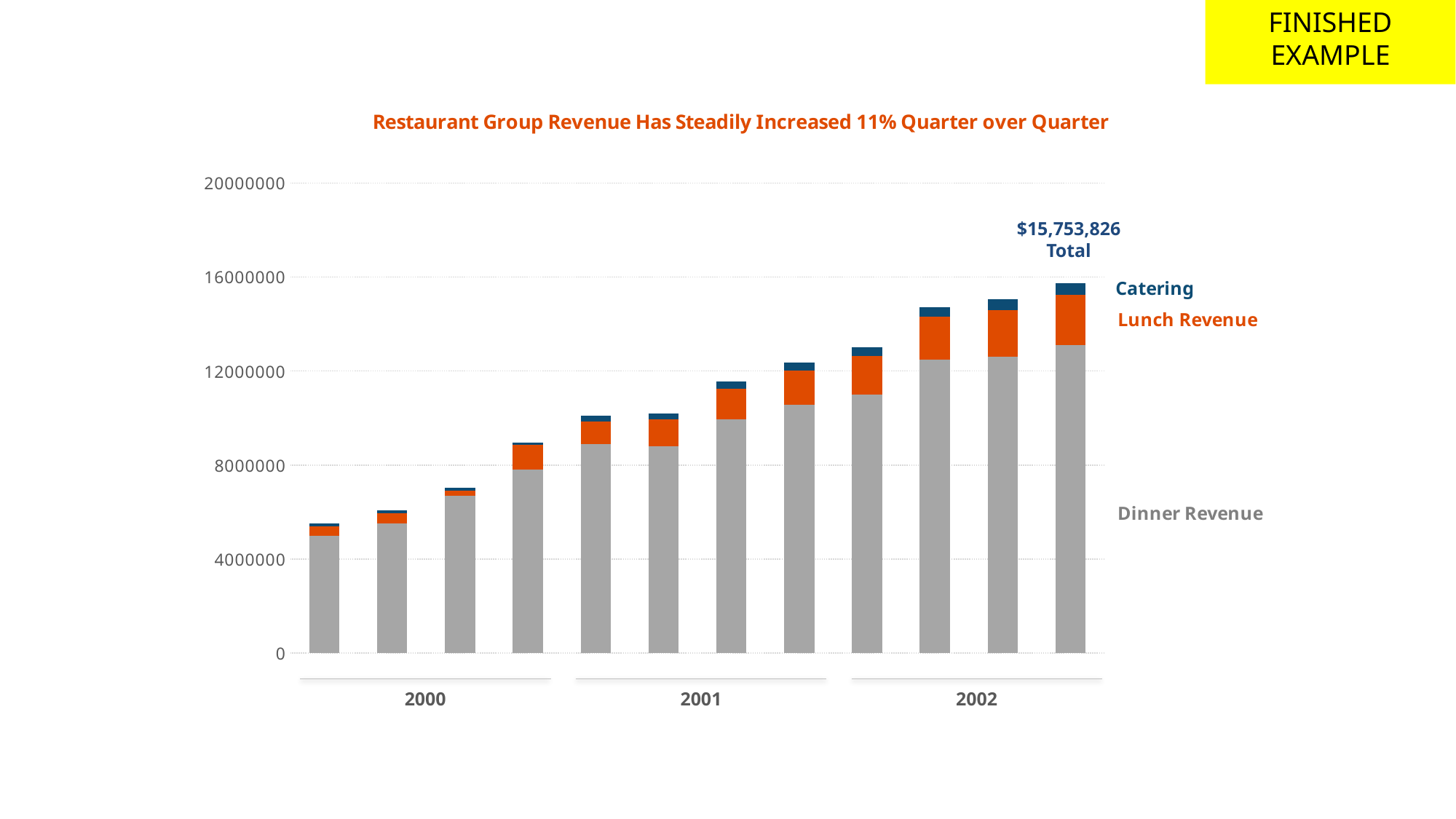
What kind of chart is shown on the slide? Stacked bar chart Is the total for the first bar of 2000 greater or less than 8000000? less How many bars are plotted in the chart? 12 How many revenue series are stacked in each bar? 3 Which is larger: the total of the first bar of 2001 or the total of the last bar of 2000? The first bar of 2001 Is the Dinner Revenue portion of the last bar of 2002 greater or less than 12000000? greater Which bar has the lowest total revenue? The first bar of 2000 Which bar has the highest total revenue? The last bar of 2002 Which series forms the bottom segment of each stacked bar? Dinner Revenue What is the labelled total for the last bar of 2002? $15,753,826 Do the bar totals rise or fall from left to right across the quarters? Rise What is the title of the chart? Restaurant Group Revenue Has Steadily Increased 11% Quarter over Quarter